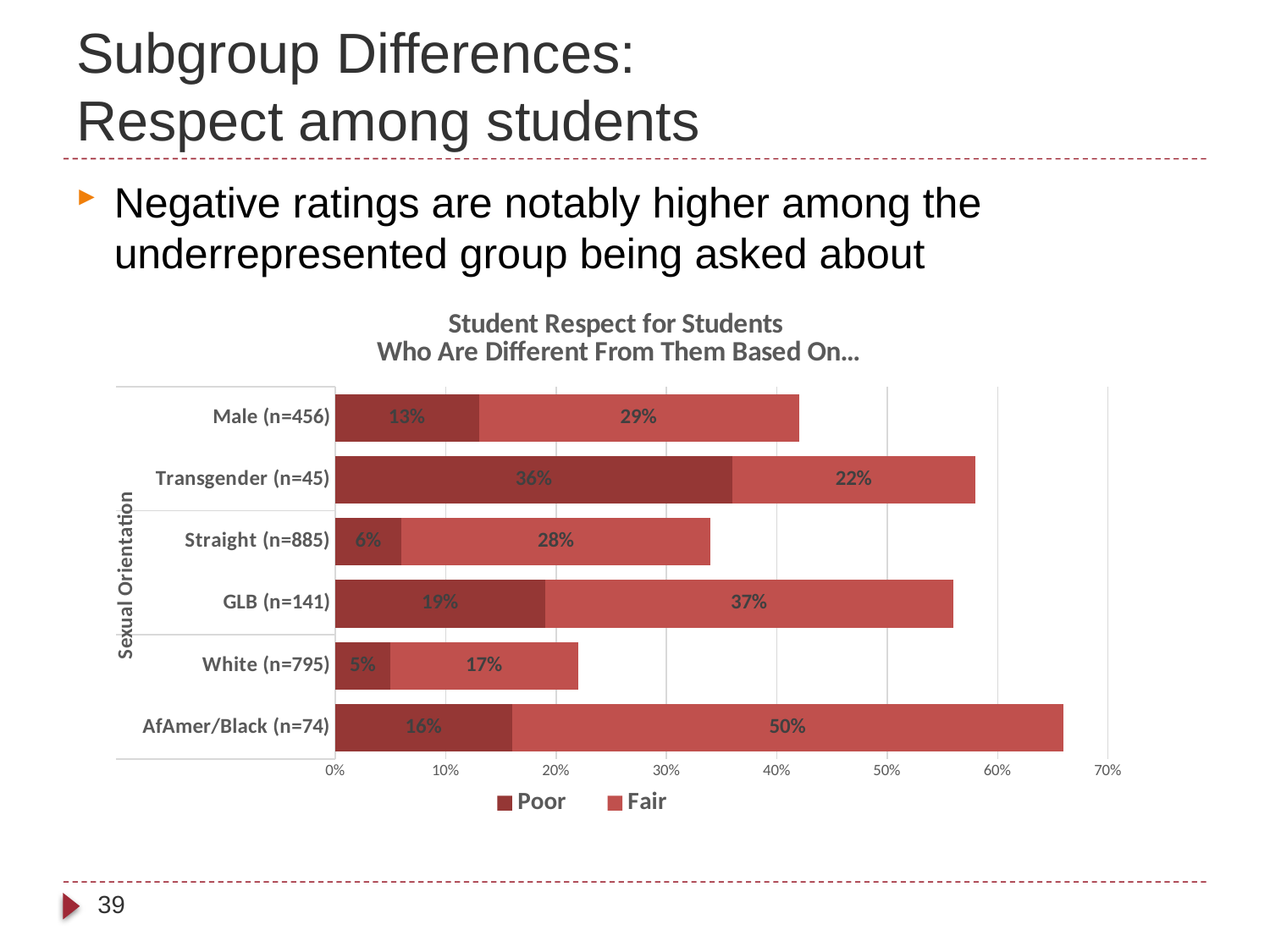
Which category has the highest Poor value? Transgender (n=45) What is the total of the stacked bar for Straight (n=885)? 34% What kind of chart is shown on the slide? Stacked bar chart What is the total of the stacked bar for AfAmer/Black (n=74)? 66% Which is larger, the Poor value for GLB (n=141) or the Poor value for Male (n=456)? GLB (n=141) What is the Fair value for AfAmer/Black (n=74)? 50% How many series does the legend list? 2 What is the Poor value for Transgender (n=45)? 36% What is the difference between the Fair values for GLB (n=141) and Straight (n=885)? 9% Which category has the lowest Fair value? White (n=795) What is the Poor value for White (n=795)? 5% How many categories are shown on the chart? 6